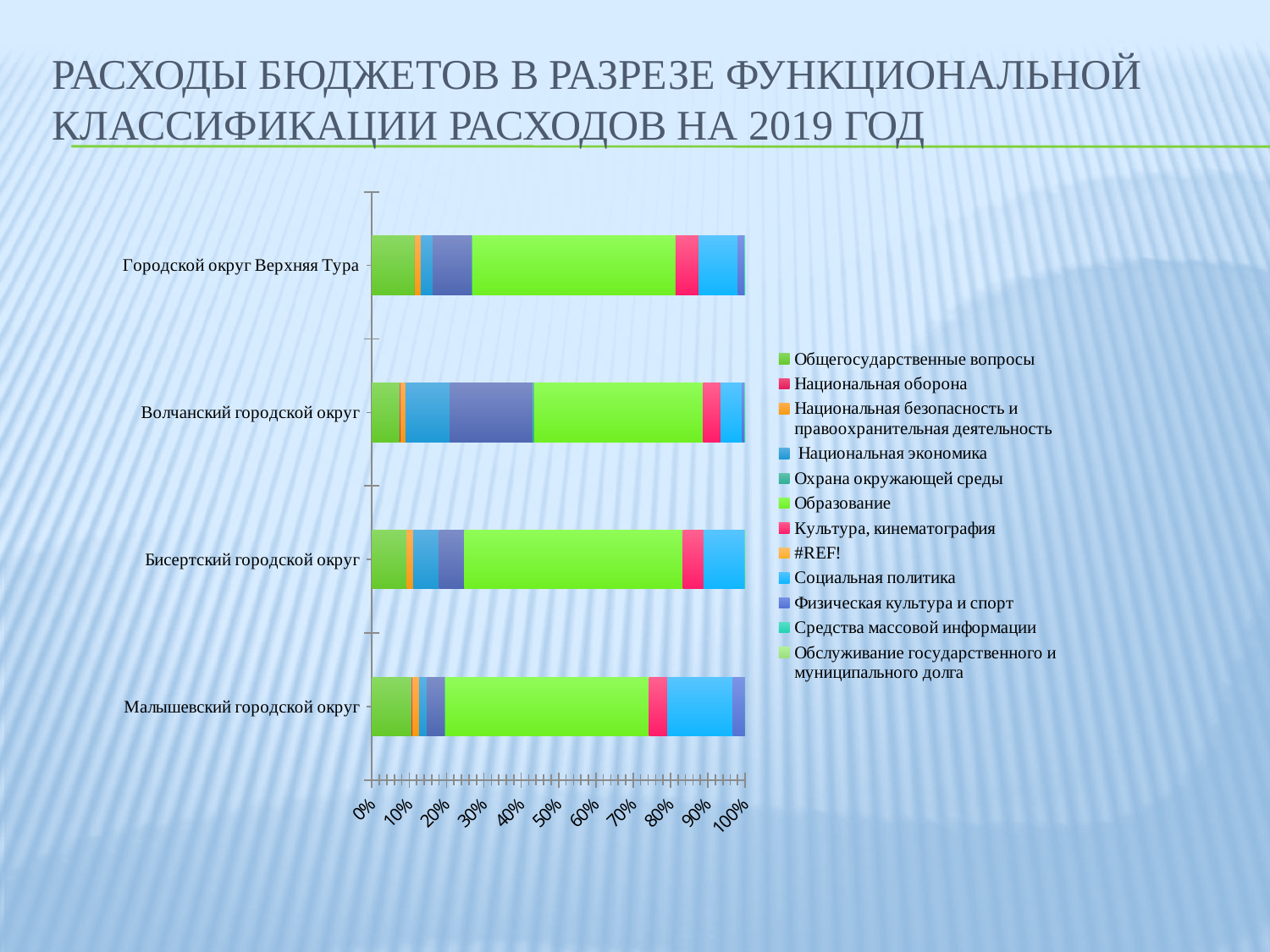
Which category is listed at the top of the chart? Городской округ Верхняя Тура How many series does the legend list? 12 Which has the larger share of Социальная политика: Малышевский городской округ or Волчанский городской округ? Малышевский городской округ How many городские округа (categories) are plotted on the chart? 4 Which округ has the largest share for Социальная политика? Малышевский городской округ Which legend entry appears as an error reference rather than a category name? #REF! What kind of chart is shown on the slide? Stacked bar chart Is the share of Образование for Городской округ Верхняя Тура greater or less than 40%? greater Is the share of Общегосударственные вопросы for Городской округ Верхняя Тура greater or less than 20%? less What is the title of the slide containing the chart? РАСХОДЫ БЮДЖЕТОВ В РАЗРЕЗЕ ФУНКЦИОНАЛЬНОЙ КЛАССИФИКАЦИИ РАСХОДОВ НА 2019 ГОД